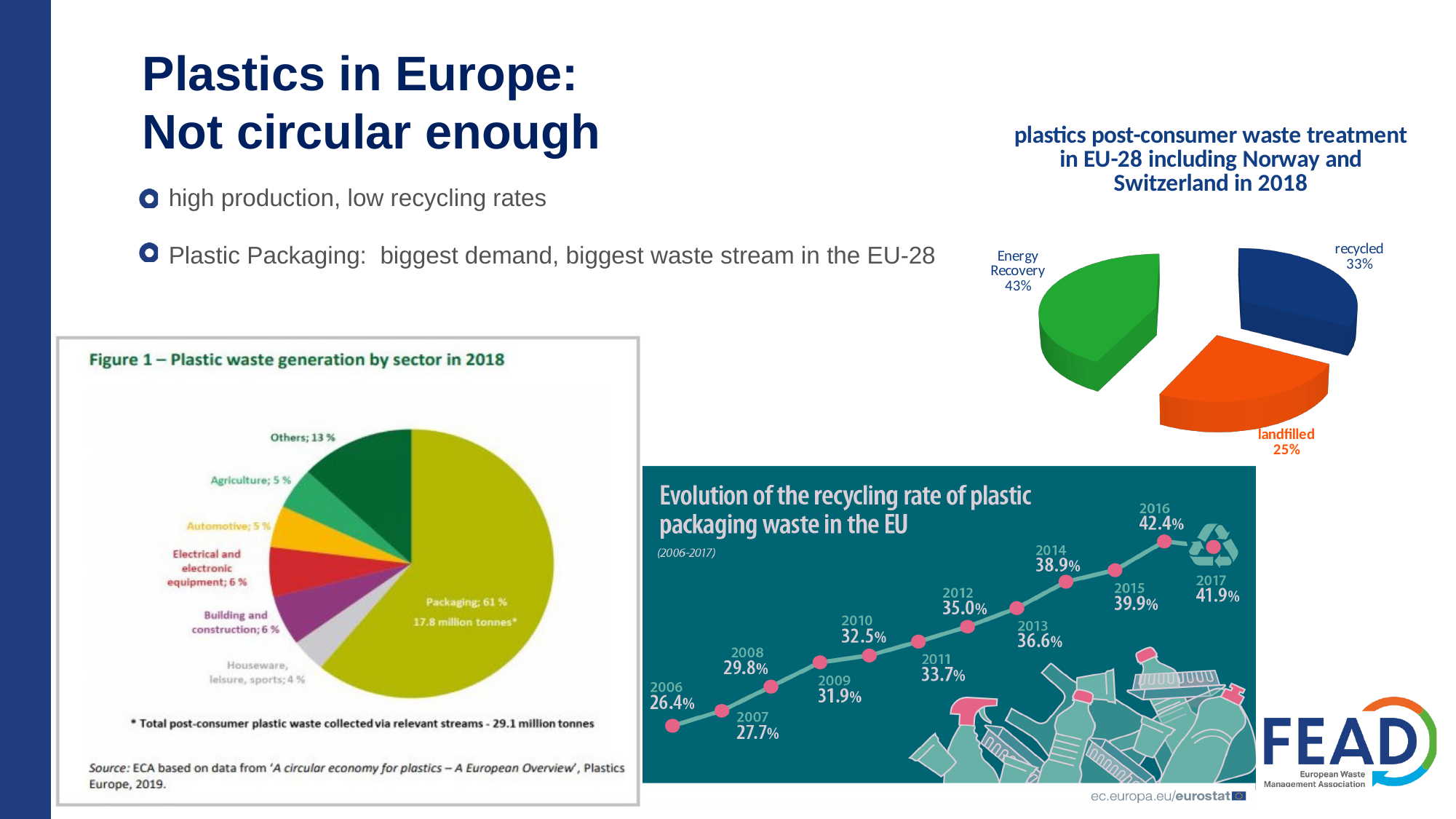
In the pie chart titled 'plastics post-consumer waste treatment in EU-28 including Norway and Switzerland in 2018', how many slices are there? 3 In the chart 'Evolution of the recycling rate of plastic packaging waste in the EU', which year had the highest recycling rate? 2016 In the chart 'Figure 1 – Plastic waste generation by sector in 2018', what share does Packaging account for? 61 % In the chart 'Figure 1 – Plastic waste generation by sector in 2018', what kind of chart is shown? Pie chart In the pie chart titled 'plastics post-consumer waste treatment in EU-28 including Norway and Switzerland in 2018', which category has the smallest share? landfilled In the chart 'Figure 1 – Plastic waste generation by sector in 2018', which sector has the smallest share? Houseware, leisure, sports In the pie chart titled 'plastics post-consumer waste treatment in EU-28 including Norway and Switzerland in 2018', what share is Energy Recovery? 43% In the chart 'Evolution of the recycling rate of plastic packaging waste in the EU', how many years are plotted? 12 In the chart 'Evolution of the recycling rate of plastic packaging waste in the EU', what was the recycling rate in 2012? 35.0% In the chart 'Evolution of the recycling rate of plastic packaging waste in the EU', what is the difference between the 2017 and 2006 recycling rates? 15.5% In the pie chart titled 'plastics post-consumer waste treatment in EU-28 including Norway and Switzerland in 2018', what is the difference between the recycled and landfilled shares? 8% In the chart 'Figure 1 – Plastic waste generation by sector in 2018', how many million tonnes of plastic waste does Packaging represent? 17.8 million tonnes